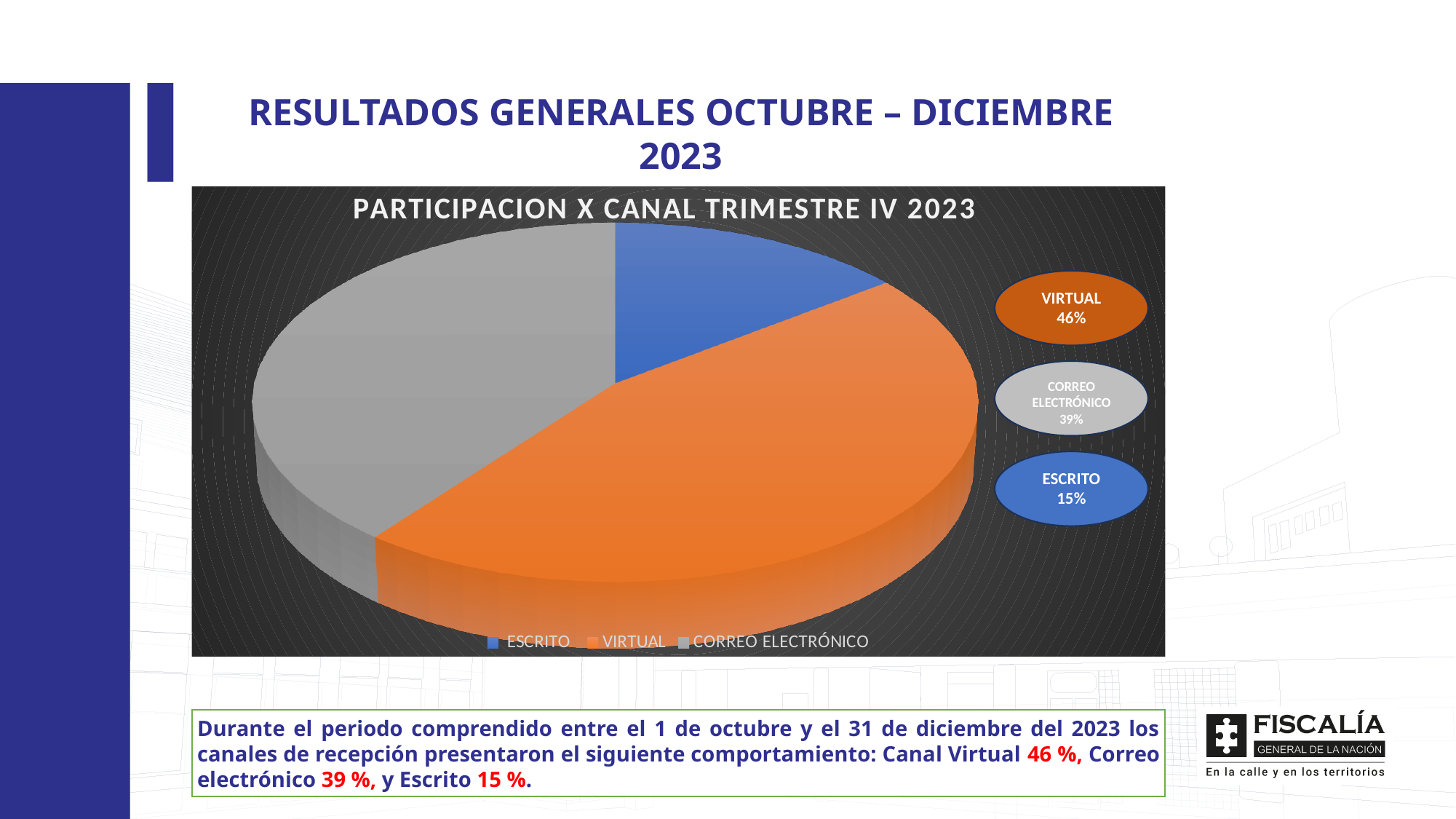
How many categories does the pie chart have? 3 What share of the pie does CORREO ELECTRÓNICO represent? 39% What is the difference in percentage points between CORREO ELECTRÓNICO and ESCRITO? 24 Which is larger, the share for VIRTUAL or the share for ESCRITO? VIRTUAL What share of the pie does VIRTUAL represent? 46% Which channel has the largest share of the pie? VIRTUAL What is the title of the chart? PARTICIPACION X CANAL TRIMESTRE IV 2023 What is the difference in percentage points between VIRTUAL and CORREO ELECTRÓNICO? 7 What share of the pie does ESCRITO represent? 15% What type of chart is shown on the slide? Pie chart Which colour represents CORREO ELECTRÓNICO in the chart? Grey Which channel has the smallest share of the pie? ESCRITO